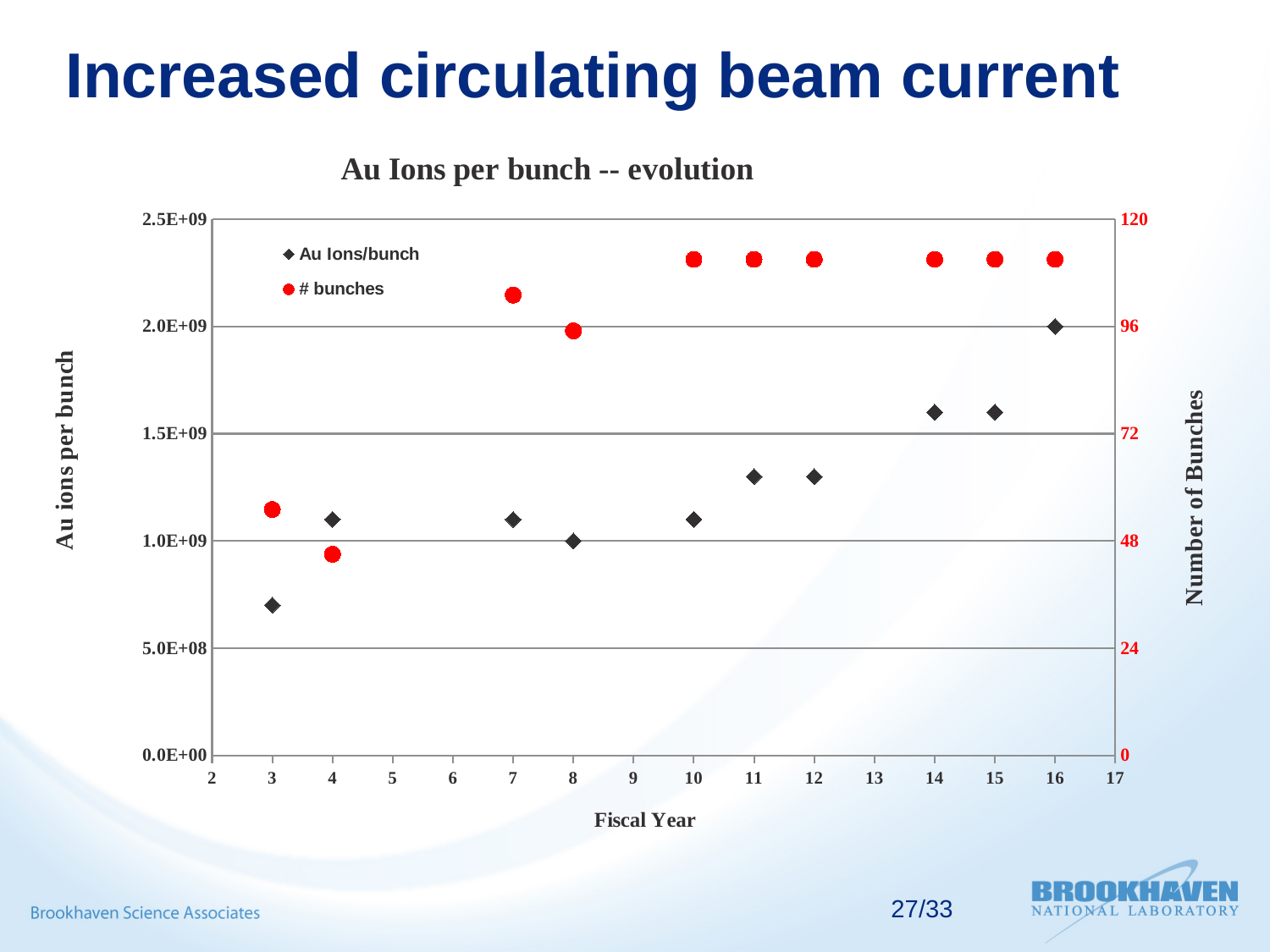
How many data points are plotted for the Au Ions/bunch series? 10 How many series does the legend list? 2 Which fiscal year has the lowest Au Ions/bunch value? 3 Which has the larger Au Ions/bunch value, fiscal year 11 or fiscal year 14? fiscal year 14 Is the # bunches value for fiscal year 10 greater or less than 96? greater What is the Au Ions/bunch value for fiscal year 16? 2.0E+09 Is the Au Ions/bunch value for fiscal year 3 greater or less than 1.0E+09? less What is the title of the chart? Au Ions per bunch -- evolution Which fiscal year has the lowest # bunches value? 4 What kind of chart is shown on the slide? scatter chart Which fiscal year has the highest Au Ions/bunch value? 16